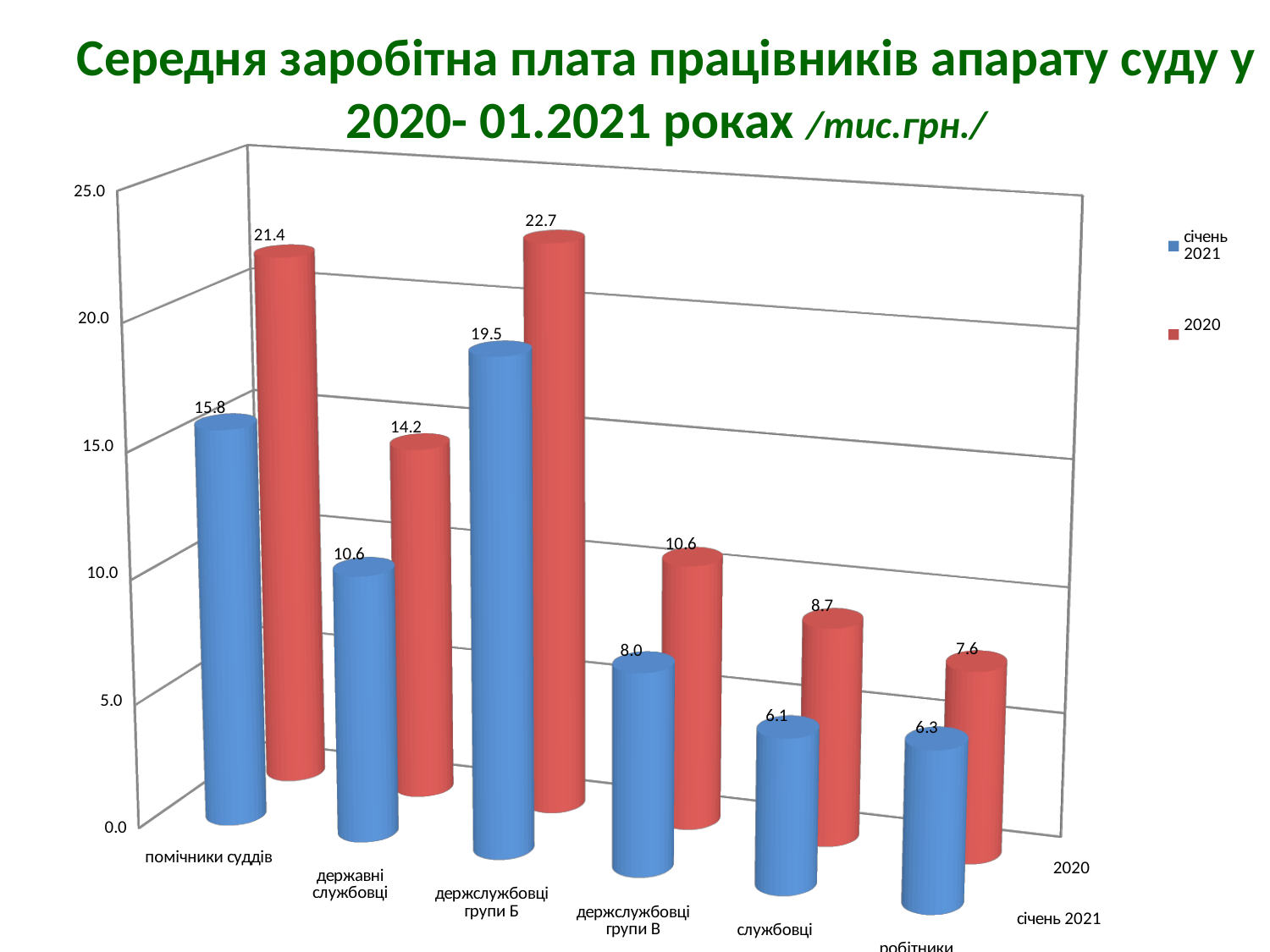
What is the value for помічники суддів in the січень 2021 series? 15.8 What is the value for робітники in the 2020 series? 7.6 How many categories are shown on the x axis? 6 What is the difference between the 2020 and січень 2021 values for помічники суддів? 5.6 Which category has the highest value in the 2020 series? держслужбовці групи Б Which is larger for державні службовці: the 2020 value or the січень 2021 value? 2020 What kind of chart is shown on the slide? bar chart What is the value for держслужбовці групи Б in the 2020 series? 22.7 How many series does the legend list? 2 What is the value for службовці in the січень 2021 series? 6.1 Which category has the lowest value in the січень 2021 series? службовці Which colour represents the 2020 series? red